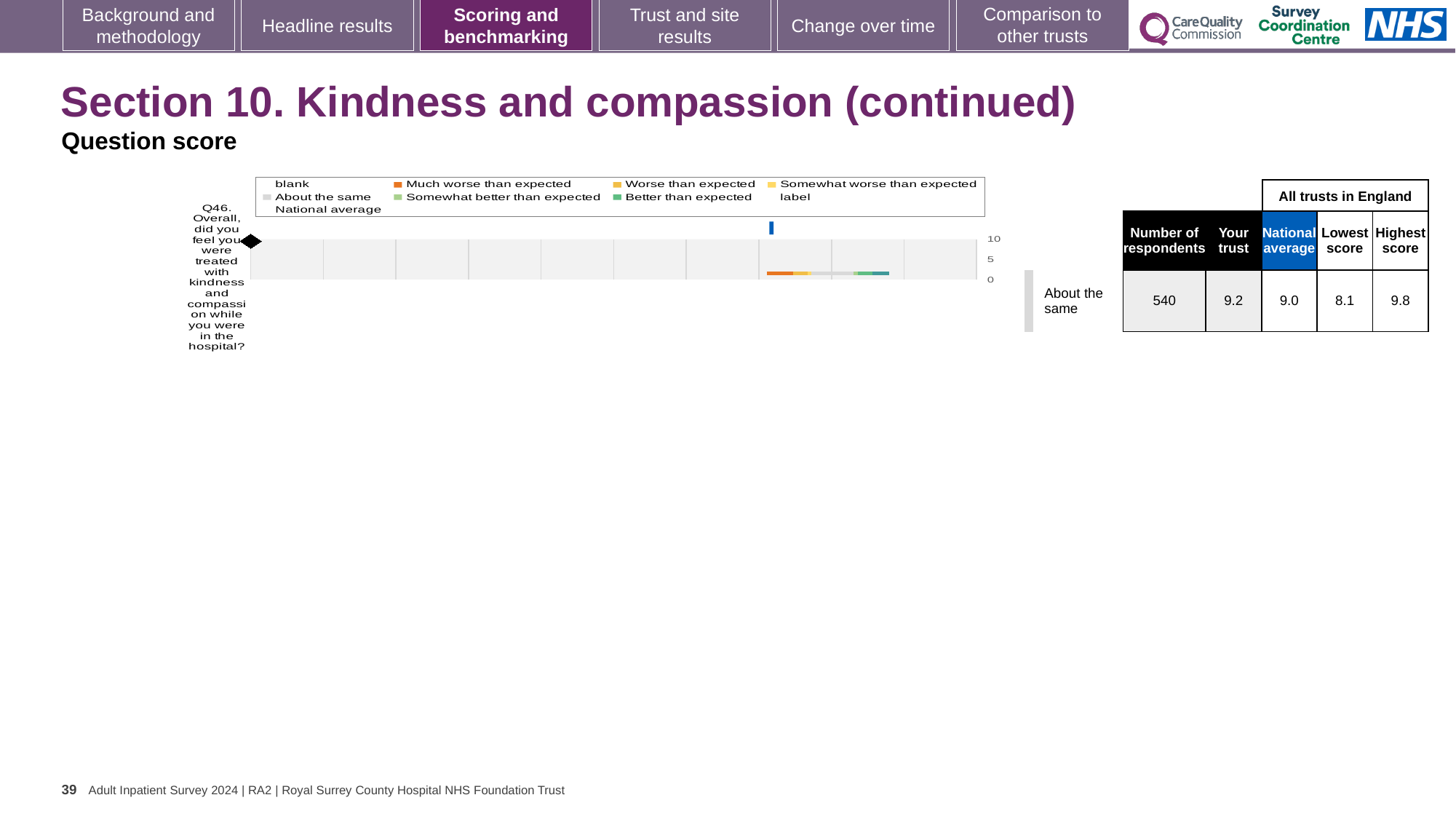
What kind of chart is shown on the slide? bar chart What is the difference between the highest and lowest scores for Q46 across all trusts in England? 1.7 How many questions (categories) are plotted in the chart? 1 What benchmark category is the trust's Q46 score placed in? About the same In the table next to the chart, how many respondents answered Q46? 540 In the table next to the chart, what is the Highest score among all trusts in England for Q46? 9.8 Which question number is plotted in the chart? Q46 What is the highest tick value shown on the chart's score axis? 10 In the table next to the chart, what is the National average score for Q46? 9.0 In the table next to the chart, what is the 'Your trust' score for Q46? 9.2 In the table next to the chart, what is the Lowest score among all trusts in England for Q46? 8.1 Is the trust's score for Q46 higher or lower than the national average? higher